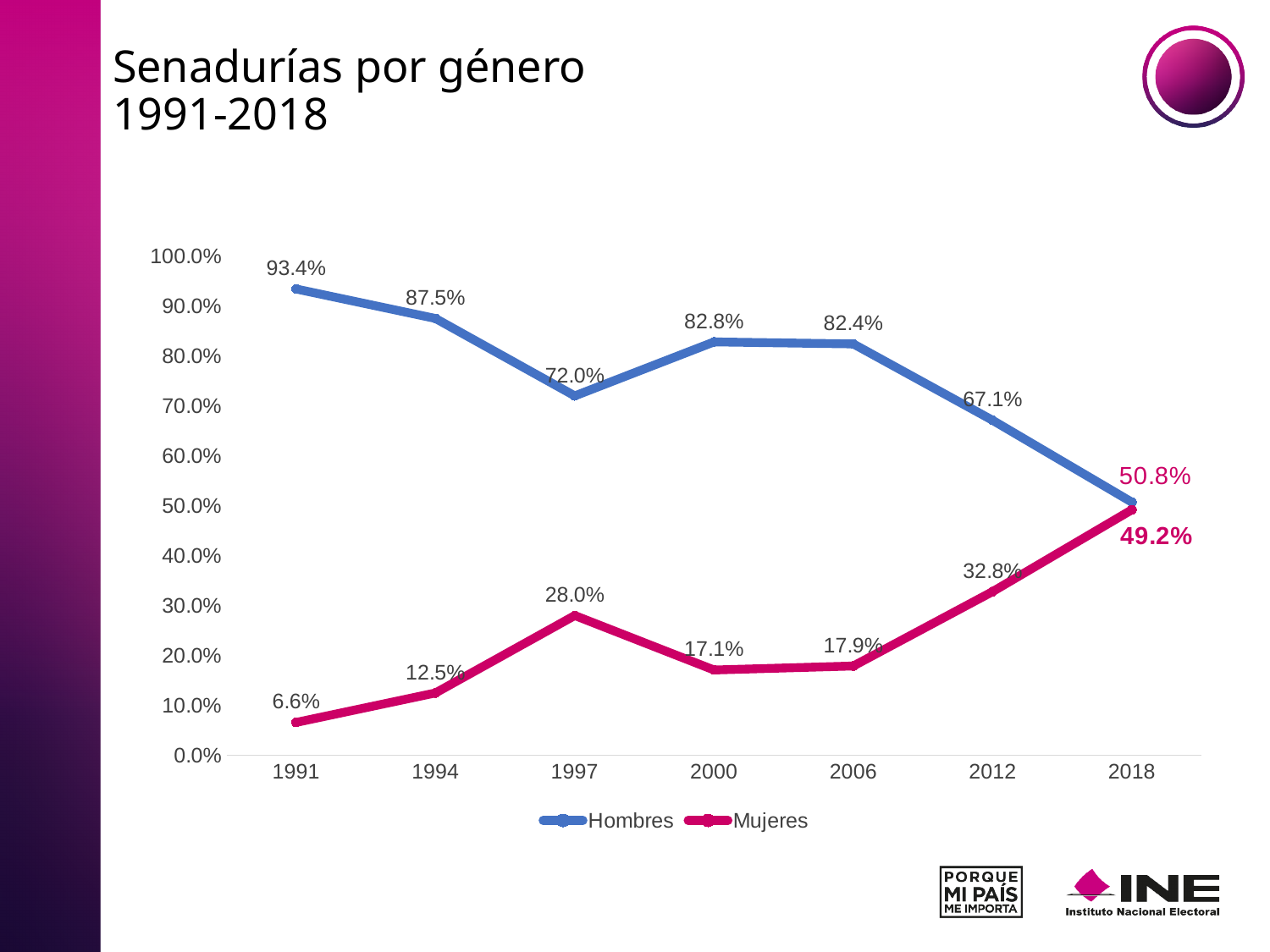
How many series does the legend list? 2 Which is larger in 2000, the Hombres value or the Mujeres value? Hombres How many years are plotted along the x axis? 7 In which year is the Mujeres value lowest? 1991 What is the value for Hombres in 1991? 93.4% What is the value for Mujeres in 2012? 32.8% In which year is the Hombres value highest? 1991 What type of chart is shown on the slide? line chart What colour is the line for Mujeres? pink What is the value for Mujeres in 1997? 28.0% What is the difference between the Hombres and Mujeres values in 2006? 64.5% Does the Mujeres series overall rise or fall from 1991 to 2018? rise